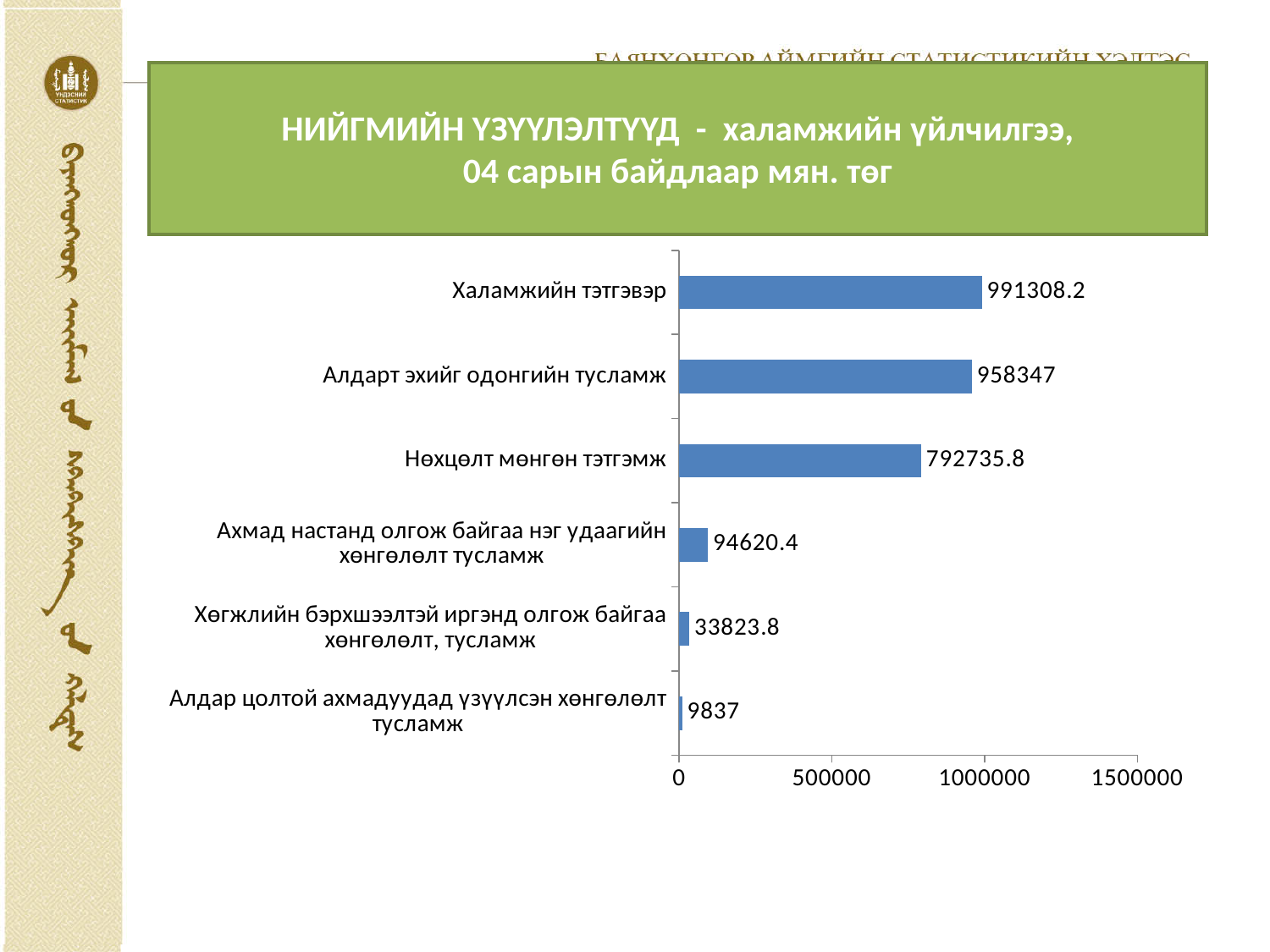
What is the value for Халамжийн тэтгэвэр? 991308.2 What is the value for Нөхцөлт мөнгөн тэтгэмж? 792735.8 Which is larger: the value for Нөхцөлт мөнгөн тэтгэмж or the value for Ахмад настанд олгож байгаа нэг удаагийн хөнгөлөлт тусламж? Нөхцөлт мөнгөн тэтгэмж What is the difference between the values for Ахмад настанд олгож байгаа нэг удаагийн хөнгөлөлт тусламж and Хөгжлийн бэрхшээлтэй иргэнд олгож байгаа хөнгөлөлт, тусламж? 60796.6 What is the value for Алдар цолтой ахмадуудад үзүүлсэн хөнгөлөлт тусламж? 9837 What kind of chart is shown on the slide? bar chart How many categories are shown in the chart? 6 What is the value for Хөгжлийн бэрхшээлтэй иргэнд олгож байгаа хөнгөлөлт, тусламж? 33823.8 Which category has the lowest value? Алдар цолтой ахмадуудад үзүүлсэн хөнгөлөлт тусламж Is the value for Нөхцөлт мөнгөн тэтгэмж greater or less than 1000000? less Which category has the highest value? Халамжийн тэтгэвэр What is the difference between the values for Халамжийн тэтгэвэр and Алдарт эхийг одонгийн тусламж? 32961.2